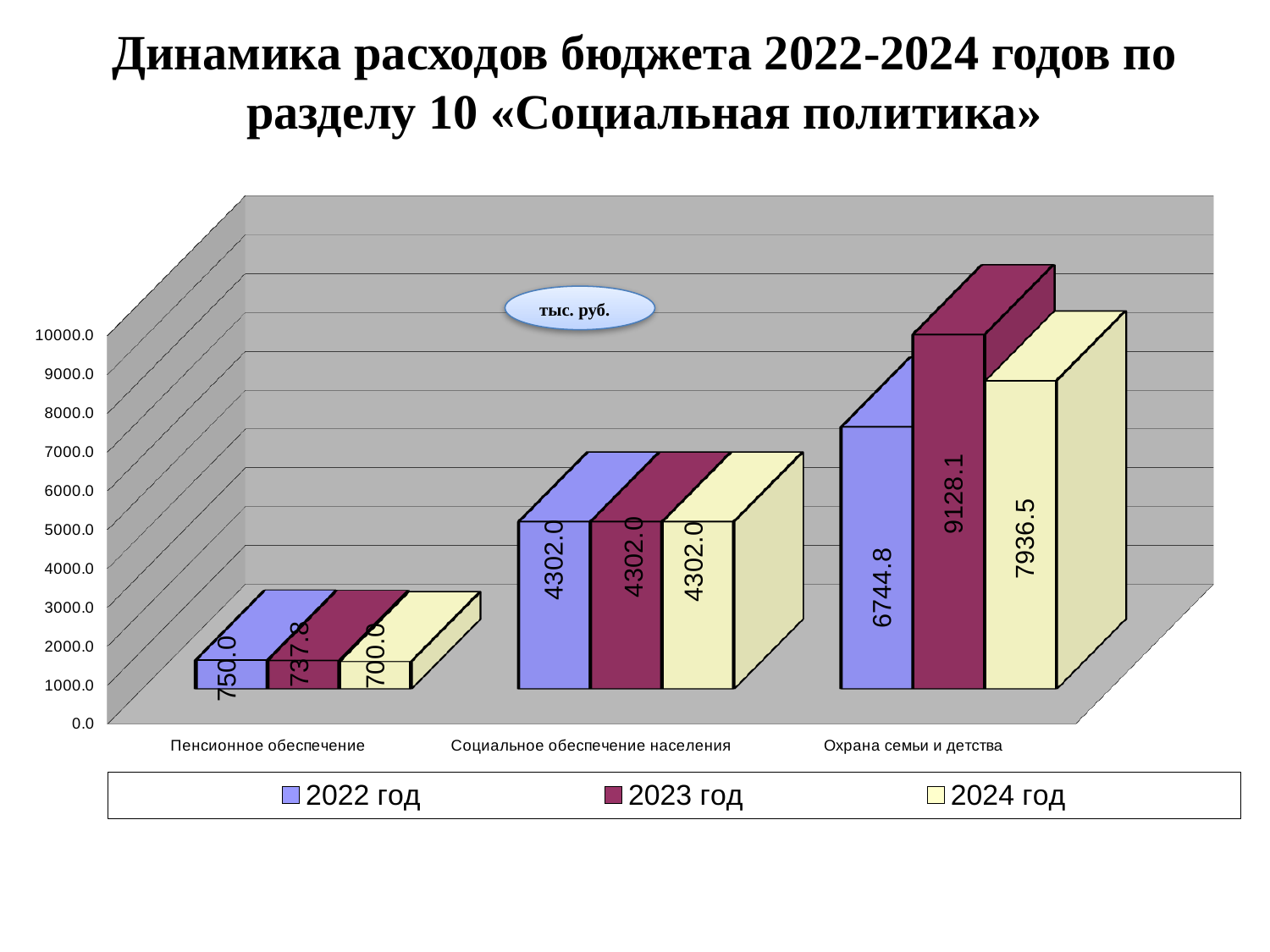
Which category has the highest value in the 2022 год series? Охрана семьи и детства Which category has the lowest value in the 2024 год series? Пенсионное обеспечение What is the value for Пенсионное обеспечение in the 2022 год series? 750.0 Which is larger for Охрана семьи и детства: the 2023 год value or the 2024 год value? 2023 год What is the difference between the 2022 год and 2024 год values for Пенсионное обеспечение? 50.0 How many categories are shown on the x axis? 3 What kind of chart is shown on the slide? Bar chart What is the value for Охрана семьи и детства in the 2024 год series? 7936.5 What is the difference between the 2023 год and 2022 год values for Охрана семьи и детства? 2383.3 How many series does the legend list? 3 What is the value for Социальное обеспечение населения in the 2024 год series? 4302.0 What is the value for Охрана семьи и детства in the 2023 год series? 9128.1